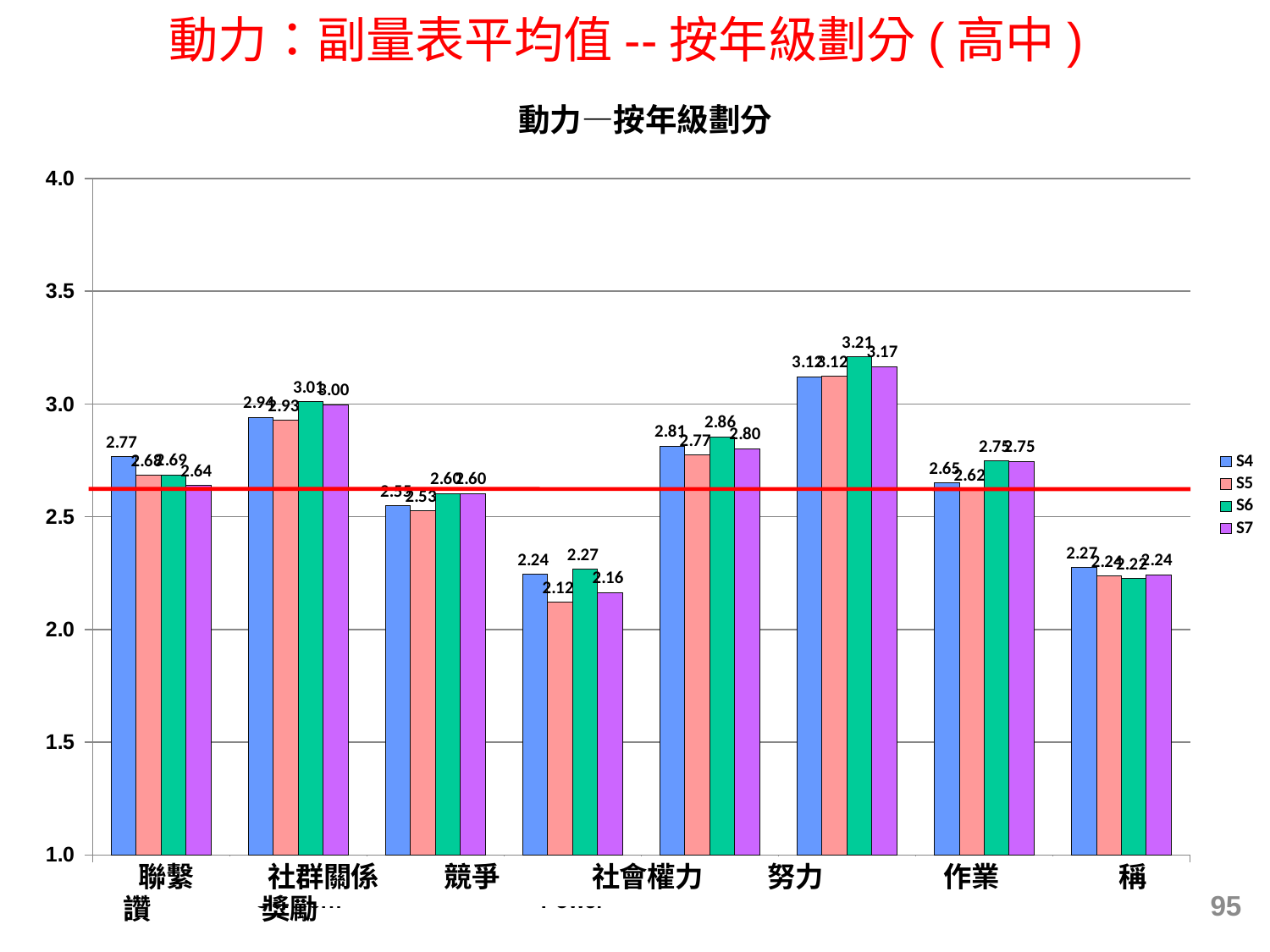
What is the title of the chart? 動力─按年級劃分 What type of chart is shown on the slide? bar chart What is the difference between S6 and S5 in the 社會權力 category? 0.15 Which category has the lowest value for S5? 社會權力 How many series does the legend list? 4 What is the value for S7 in the 競爭 category? 2.60 What is the value for S5 in the 社會權力 category? 2.12